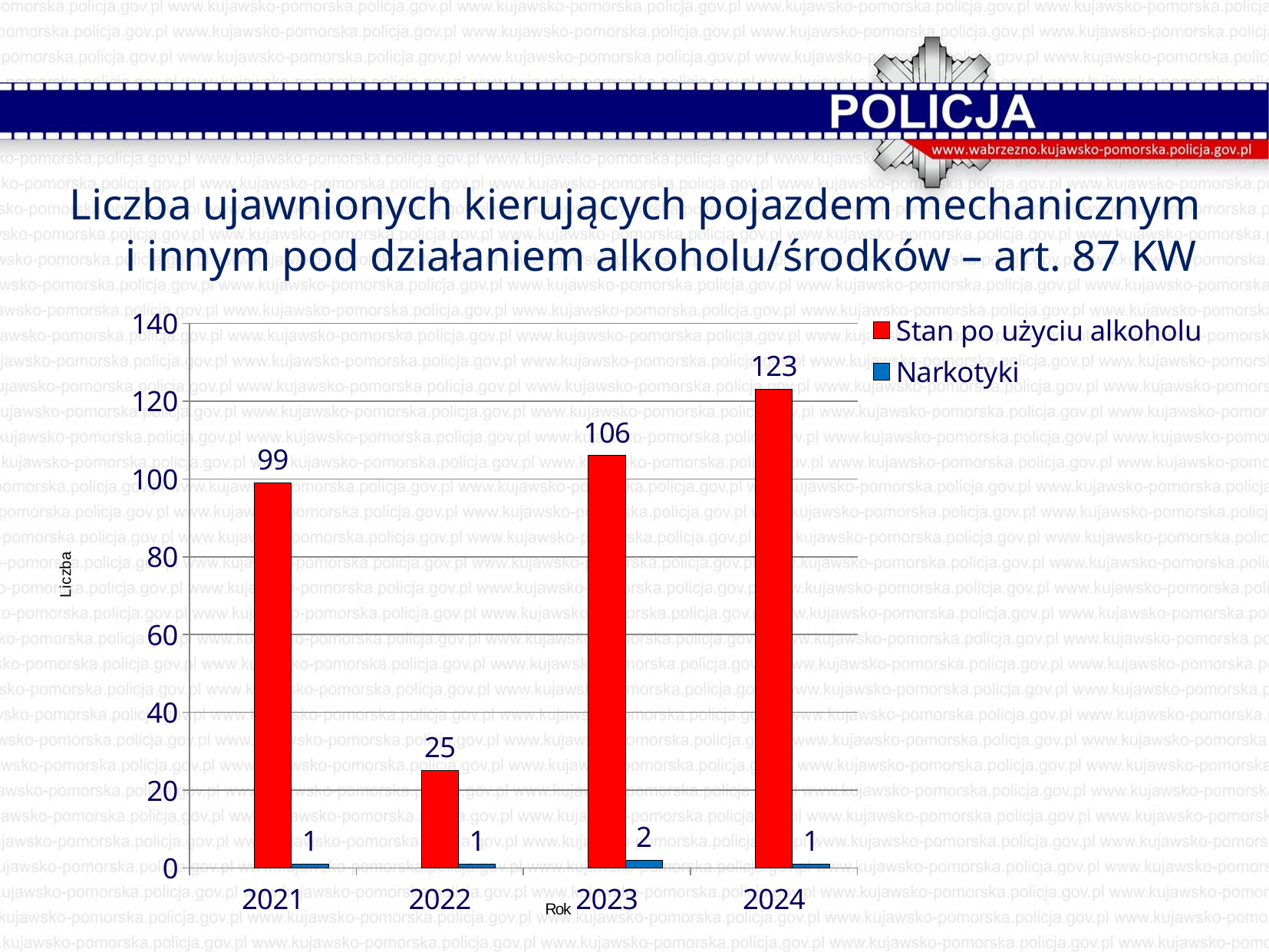
How many series does the legend list? 2 What is the label of the y axis? Liczba Which year has the lowest value for 'Stan po użyciu alkoholu'? 2022 Is the value for 'Stan po użyciu alkoholu' in 2024 greater or less than 120? greater Which is larger: the 'Stan po użyciu alkoholu' value for 2021 or for 2023? 2023 What is the value for 'Stan po użyciu alkoholu' in 2024? 123 What kind of chart is shown on the slide? bar chart What is the difference between the 'Stan po użyciu alkoholu' values for 2024 and 2023? 17 What is the value for 'Narkotyki' in 2023? 2 What is the value for 'Stan po użyciu alkoholu' in 2022? 25 Which year has the highest value for 'Stan po użyciu alkoholu'? 2024 How many years are shown on the x axis? 4